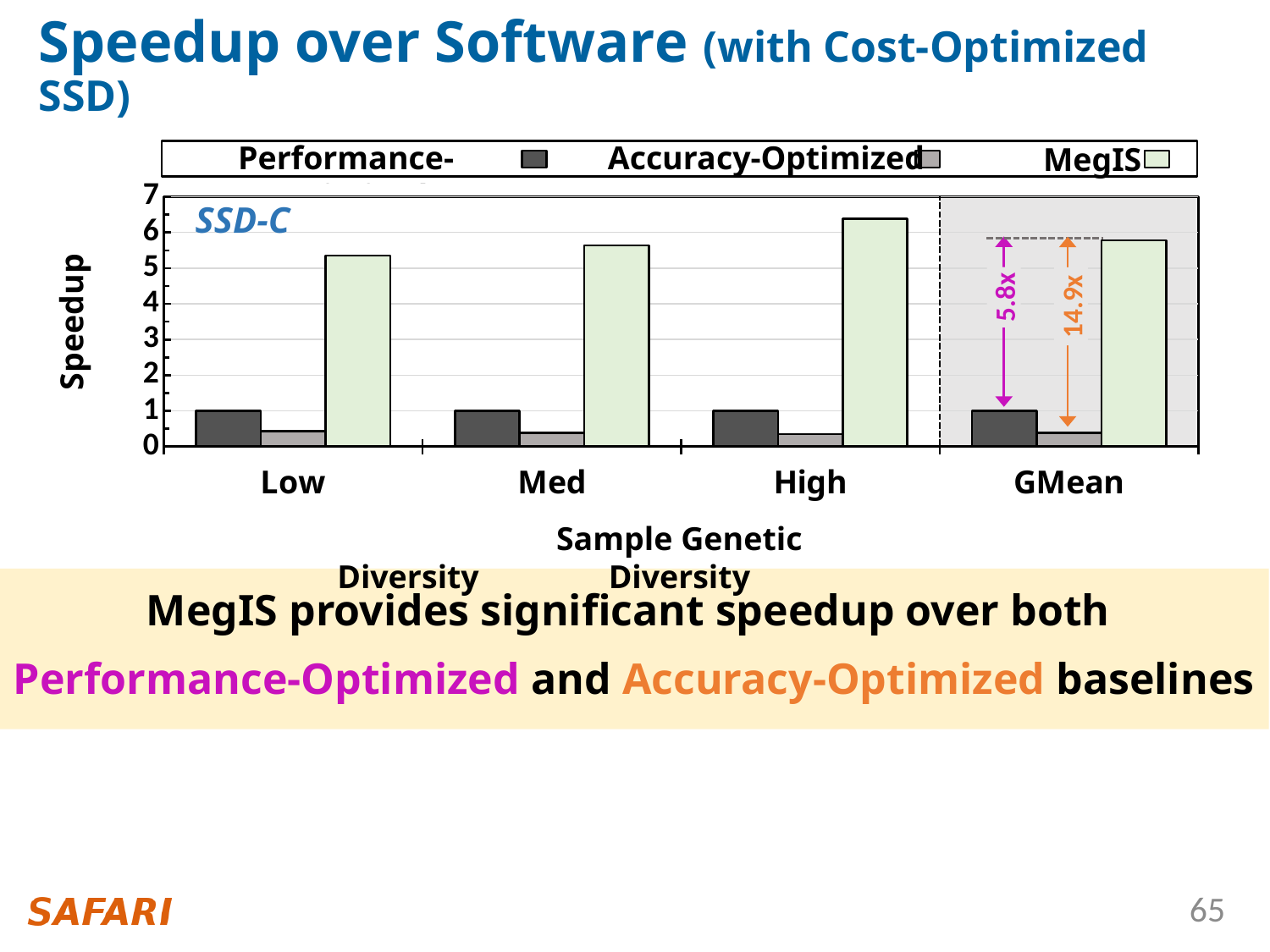
Is the Accuracy-Optimized value for Low greater or less than 1? less Which category has the highest MegIS bar? High Which category has the lowest MegIS bar? Low Is the MegIS value for High greater or less than 6? greater For Med, which is larger: the MegIS bar or the Performance-Optimized bar? MegIS What kind of chart is shown on the slide? bar chart How many categories are shown on the x axis? 4 According to the annotation at GMean, what is MegIS's speedup over the Accuracy-Optimized baseline? 14.9x What is the label on the y axis? Speedup Do the MegIS values rise or fall from Low to High? rise How many series does the legend list? 3 Is the MegIS value for Low greater or less than 5? greater